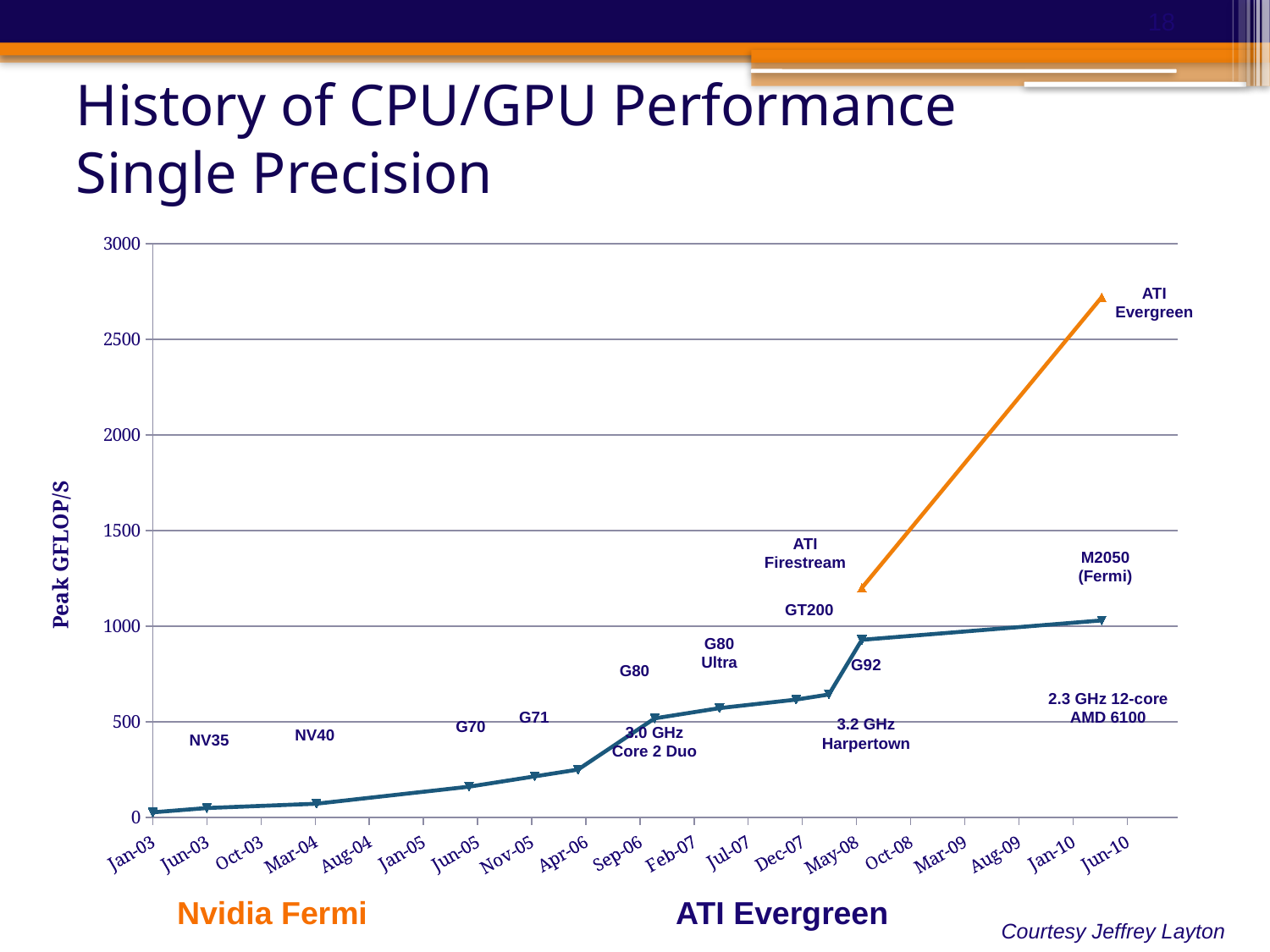
Is the value for NV40 greater or less than 500? less What kind of chart is shown on the slide? line chart Which labelled point has the highest Peak GFLOP/S value? ATI Evergreen What is the label of the y axis? Peak GFLOP/S Which labelled point has the lowest Peak GFLOP/S value? NV35 How many lines are plotted on the chart? 2 Is the value for ATI Evergreen greater or less than 2500? greater Is the value for M2050 (Fermi) greater or less than 1500? less Which has the larger value, ATI Evergreen or M2050 (Fermi)? ATI Evergreen Do the values along the blue line rise or fall from Jan-03 to Jun-10? rise